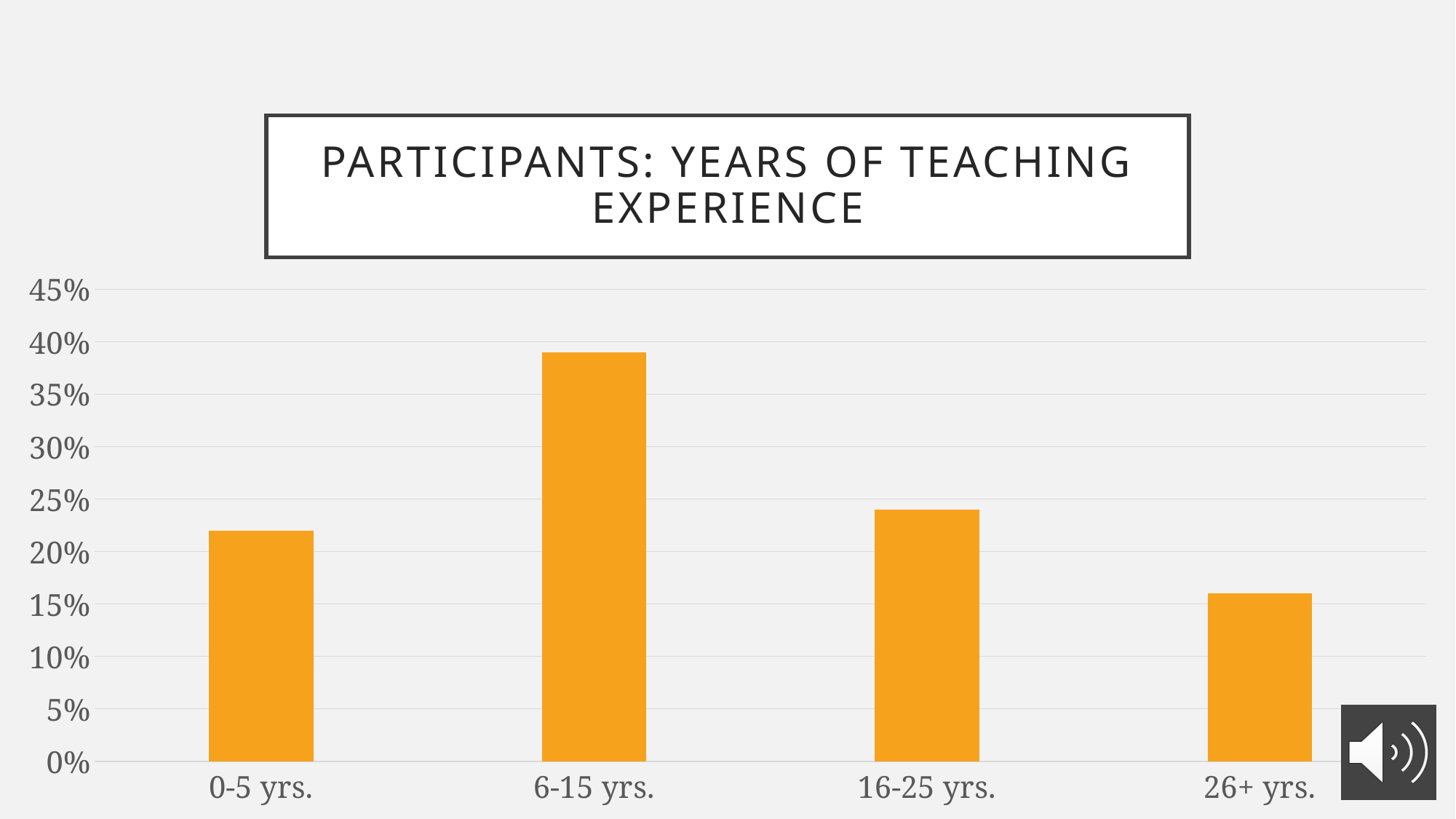
How many categories of teaching experience are shown on the x axis? 4 Which is larger, the value for 0-5 yrs. or the value for 26+ yrs.? 0-5 yrs. What kind of chart is shown on the slide? bar chart Which is larger, the value for 6-15 yrs. or the value for 16-25 yrs.? 6-15 yrs. Which category has the highest percentage of participants? 6-15 yrs. Is the value for 6-15 yrs. greater or less than 35%? greater Is the value for 0-5 yrs. greater or less than 25%? less Which category has the lowest percentage of participants? 26+ yrs. What is the title of the chart? Participants: Years of Teaching Experience Is the value for 26+ yrs. greater or less than 20%? less What is the highest value shown on the y axis? 45%